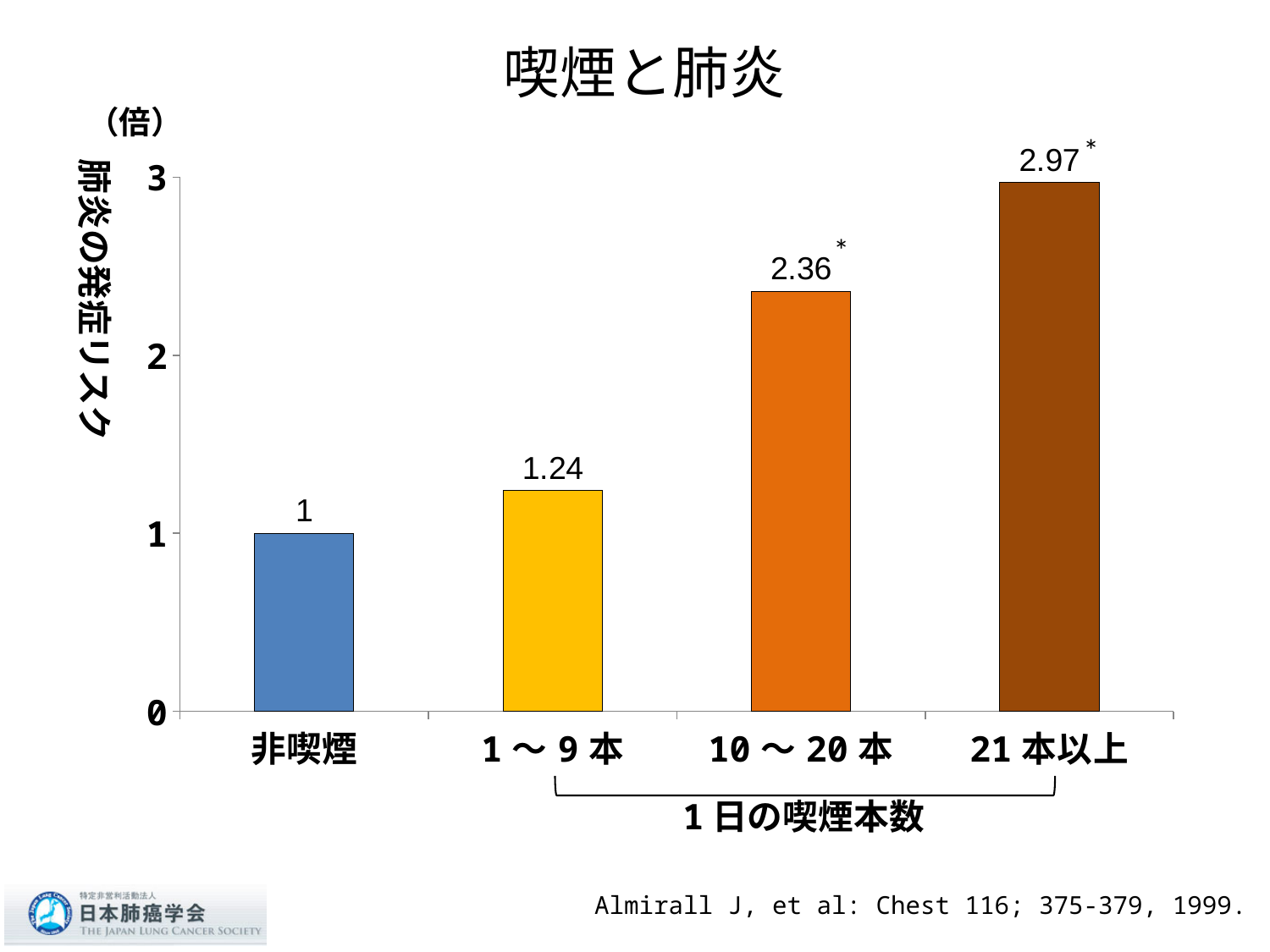
What is the pneumonia risk value for 10～20本? 2.36 How many categories are shown on the x axis? 4 Do the values rise or fall from left to right along the x axis? Rise Which category has the highest pneumonia risk? 21本以上 What is the difference between the values for 21本以上 and 10～20本? 0.61 Which category has the lowest pneumonia risk? 非喫煙 What is the pneumonia risk value for 21本以上? 2.97 What is the difference between the values for 1～9本 and 非喫煙? 0.24 What kind of chart is shown on the slide? Bar chart What is the pneumonia risk value for 1～9本? 1.24 What is the pneumonia risk value for 非喫煙? 1 Which is larger, the value for 10～20本 or the value for 1～9本? 10～20本